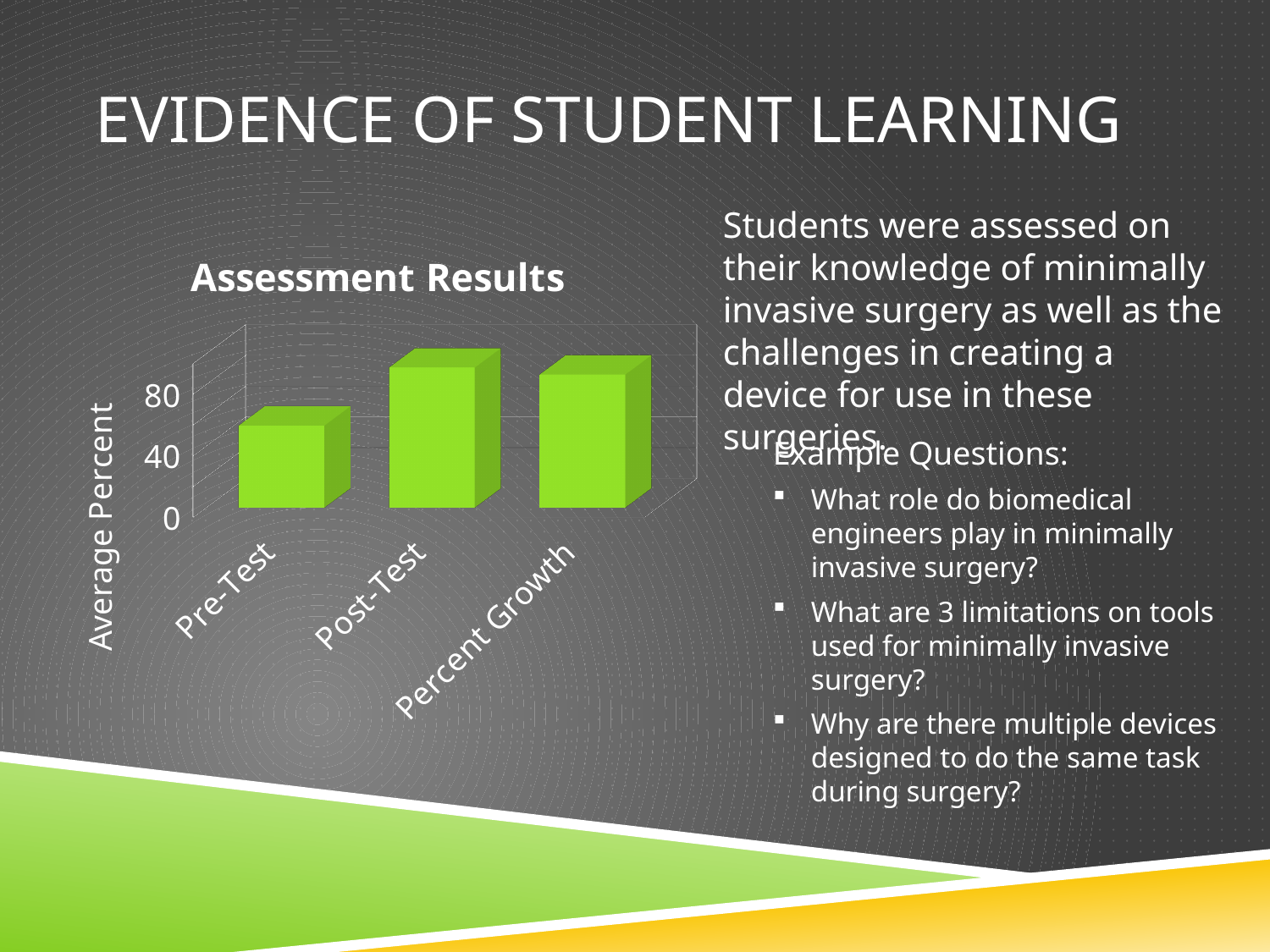
What kind of chart is shown on the slide? bar chart What is the title of the chart? Assessment Results Is the value for Post-Test greater or less than 40? greater Is the value for Pre-Test greater or less than 80? less Which is larger, the value for Pre-Test or the value for Percent Growth? Percent Growth How many categories are plotted in the Assessment Results chart? 3 Which is larger, the value for Pre-Test or the value for Post-Test? Post-Test Is the value for Percent Growth greater or less than 40? greater Which category has the highest value in the Assessment Results chart? Post-Test What is the label on the vertical axis of the chart? Average Percent Which category has the lowest value in the Assessment Results chart? Pre-Test